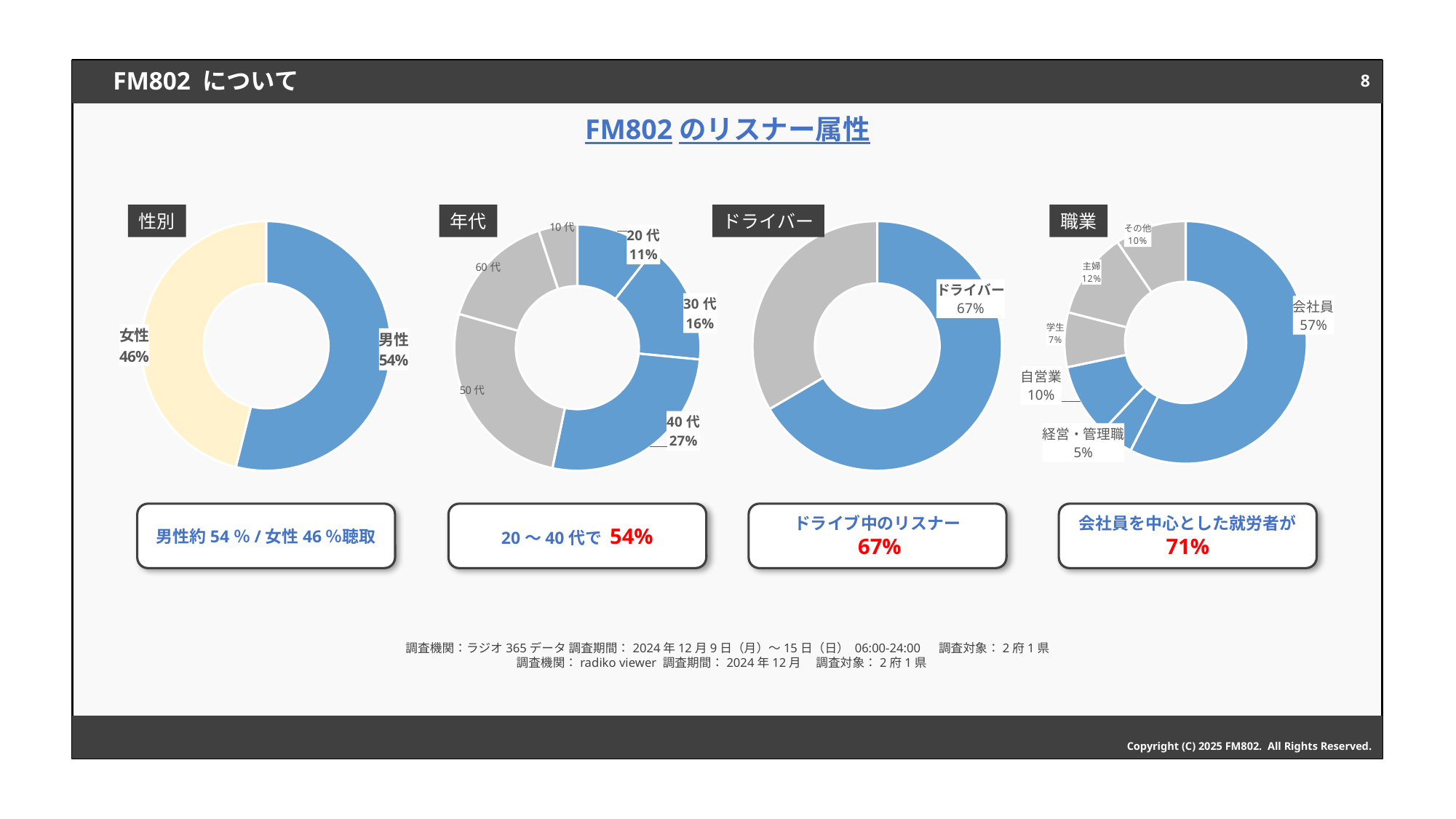
What kind of chart is used for the 性別 data? Donut (pie) chart In the 年代 chart, what percentage is shown for 20代? 11% In the 年代 chart, what percentage is shown for 40代? 27% In the 性別 chart, which is larger, 男性 or 女性? 男性 In the ドライバー chart, what percentage is shown for ドライバー? 67% In the 年代 chart, how many age categories are shown? 6 In the 年代 chart, what is the difference between the 40代 and 30代 percentages? 11% In the 性別 chart, what percentage is shown for 女性? 46% In the 性別 chart, what percentage is shown for 男性? 54% In the 職業 chart, what percentage is shown for 主婦? 12% In the 職業 chart, which occupation has the largest share? 会社員 In the 職業 chart, which occupation has the smallest share? 経営・管理職